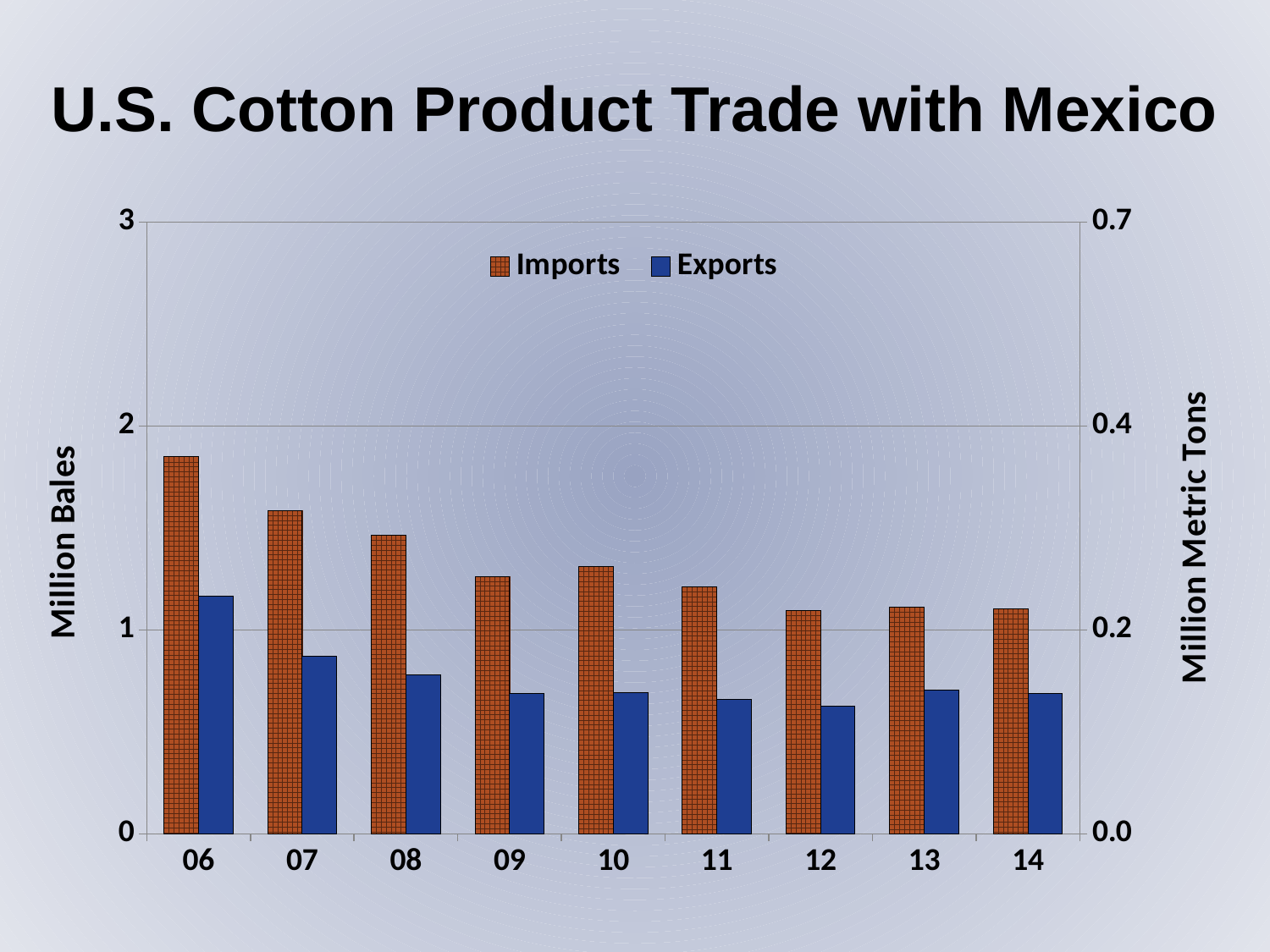
Do the Imports values generally rise or fall from 06 to 14? fall How many years are shown on the x axis? 9 Which is larger, the Imports value for 08 or the Imports value for 09? 08 What kind of chart is shown on the slide? bar chart How many series does the legend list? 2 Is the Imports value for 07 greater or less than 2 million bales? less Which year has the highest Exports value? 06 Is the Exports value for 06 greater or less than 1 million bales? greater Is the Exports value for 07 greater or less than 1 million bales? less Which year has the highest Imports value? 06 What is the label on the left vertical axis? Million Bales